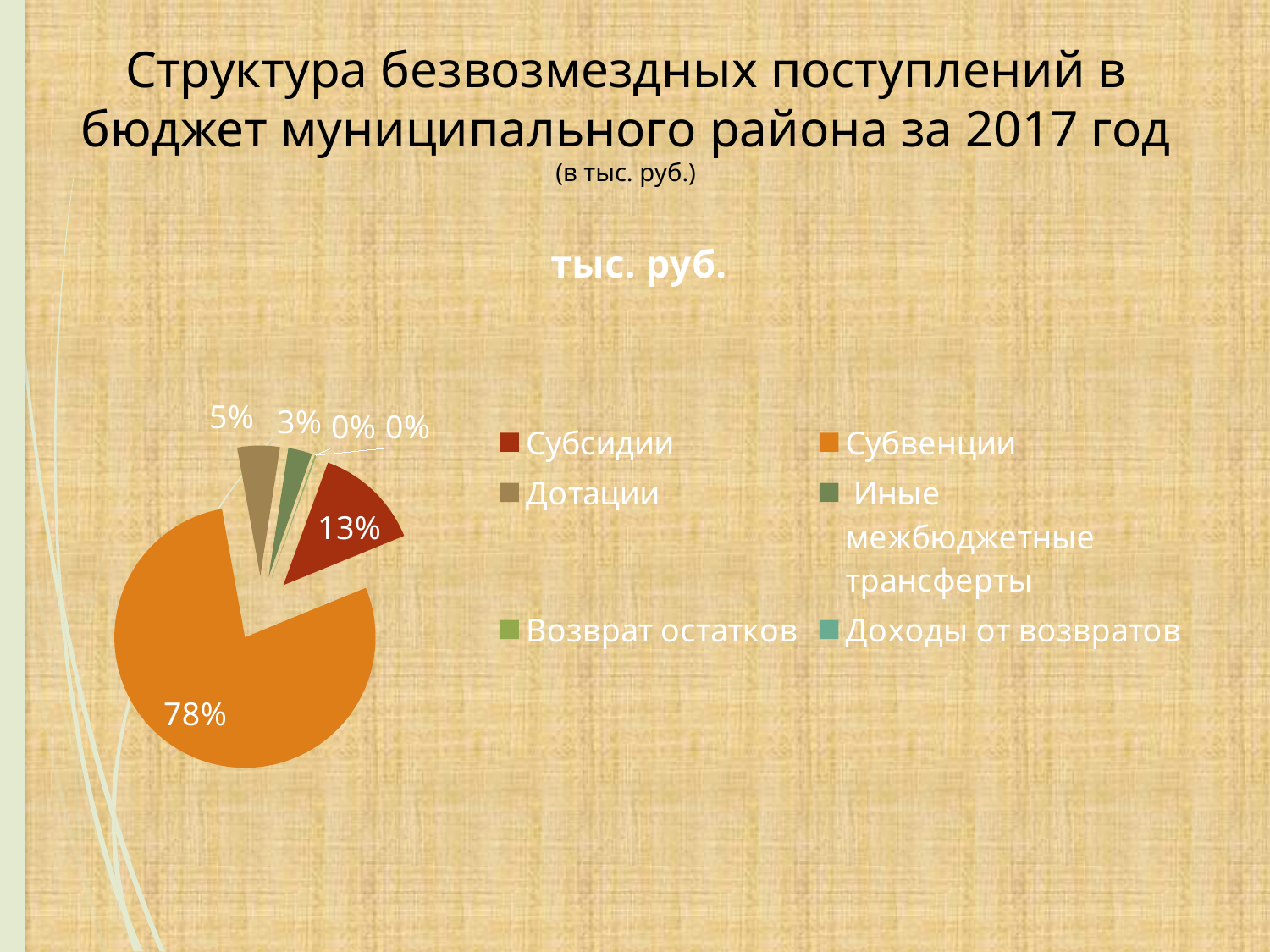
What share of the pie does Иные межбюджетные трансферты take? 3% What kind of chart is shown on the slide? pie chart Which category has the largest slice of the pie? Субвенции What share of the pie does Субвенции take? 78% What is the chart's title? тыс. руб. What is the difference in percentage points between the Дотации slice and the Иные межбюджетные трансферты slice? 2 What is the difference in percentage points between the Субвенции slice and the Субсидии slice? 65 Which is larger, the slice for Субсидии or the slice for Дотации? Субсидии What colour is the slice for Субвенции? orange What share of the pie does Субсидии take? 13% How many entries does the legend list? 6